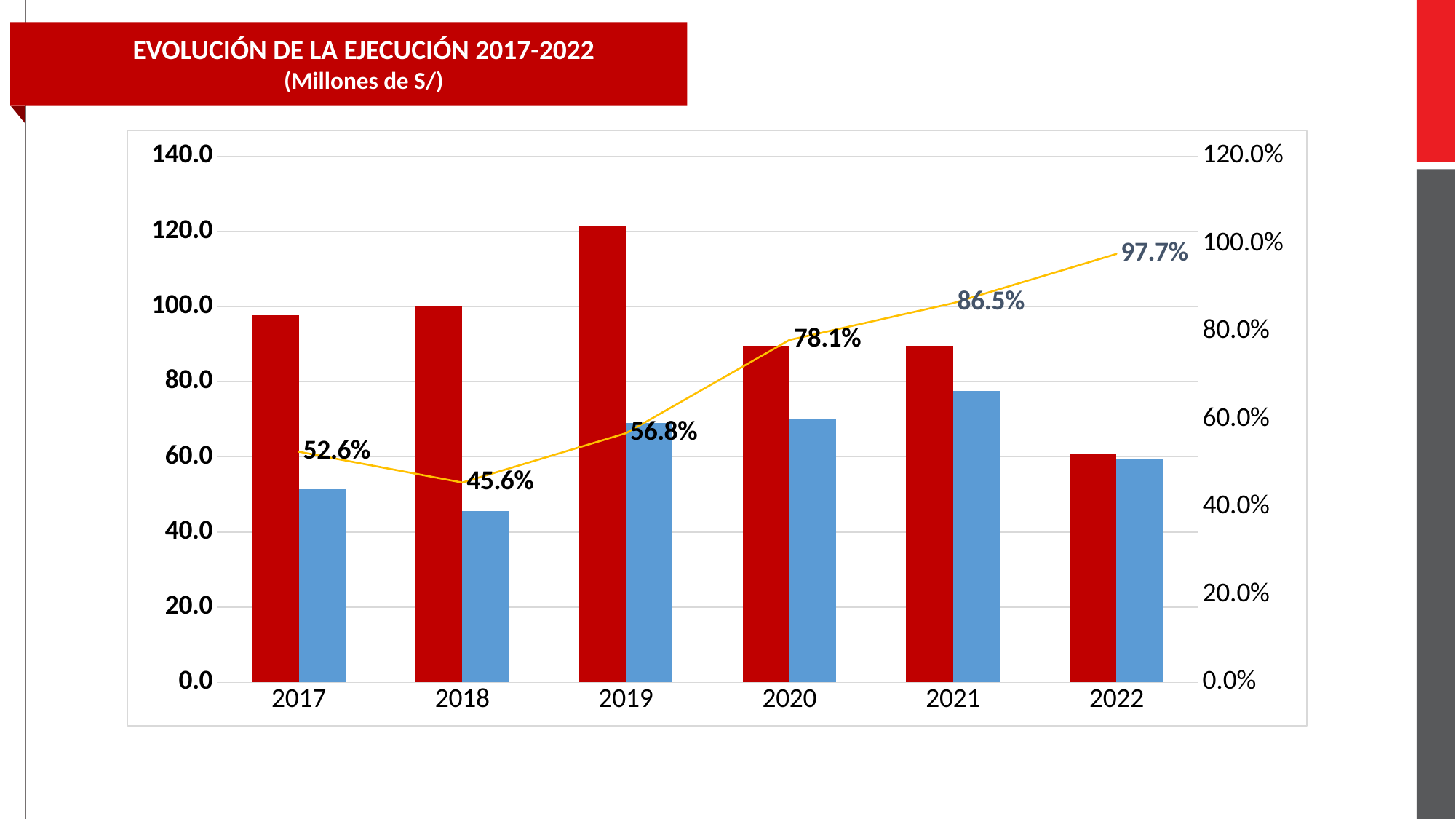
In which year does the line reach its highest percentage? 2022 Is the value of the red bar for 2022 greater or less than 80.0? less Is the value of the blue bar for 2018 greater or less than 60.0? less Does the line rise or fall from 2018 to 2022? rise Is the value of the red bar for 2019 greater or less than 100.0? greater How many years are shown on the x axis? 6 What is the percentage shown on the line for 2022? 97.7% What is the percentage shown on the line for 2018? 45.6% Which year has the tallest red bar? 2019 Which year has a higher line percentage, 2019 or 2020? 2020 In which year does the line show its lowest percentage? 2018 What is the difference between the line's percentage in 2022 and in 2017? 45.1 percentage points